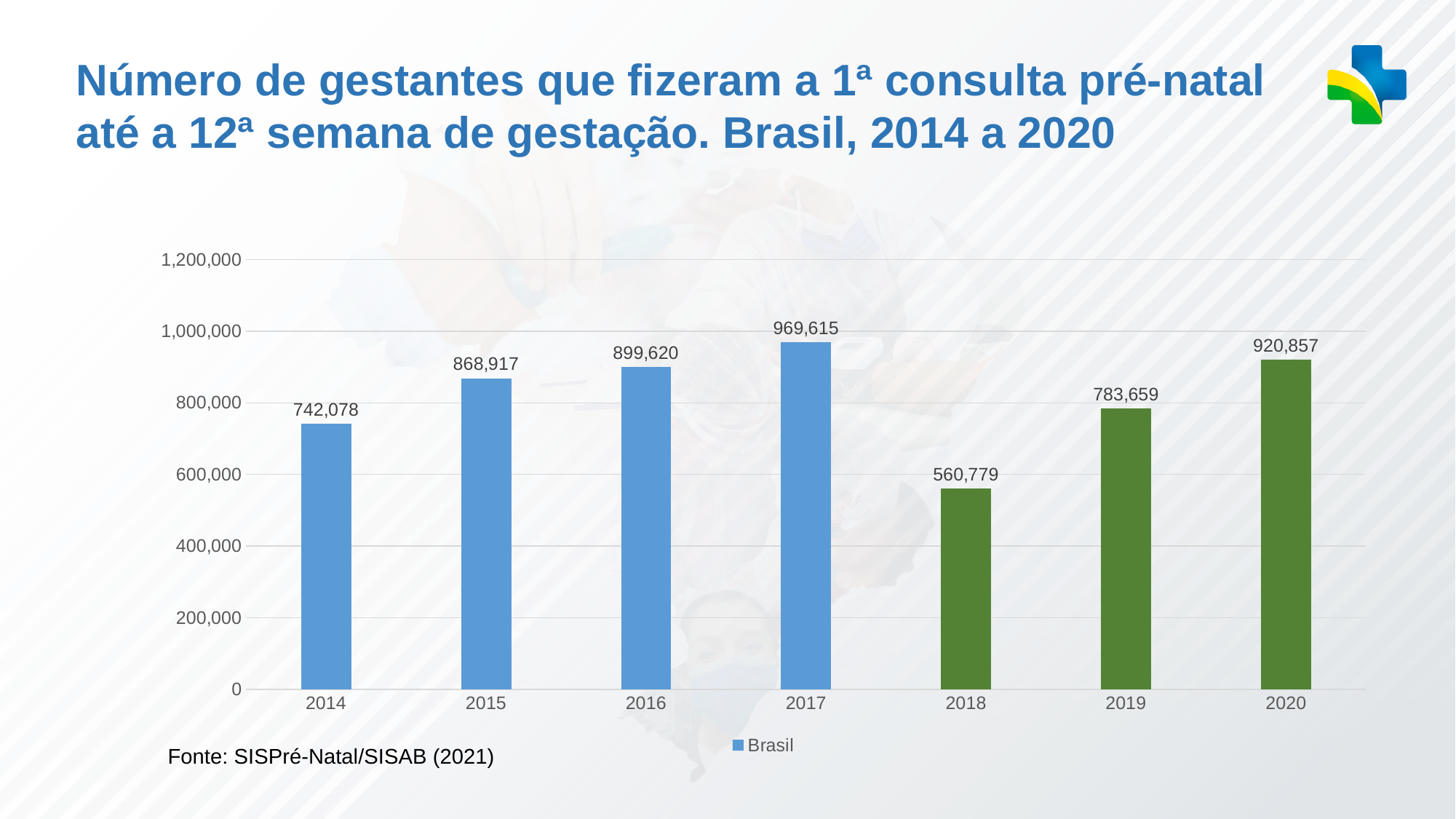
Is the value for 2015 greater or less than 800,000? greater What is the value for 2014? 742,078 What is the difference between the values for 2020 and 2019? 137,198 Which is larger, the value for 2016 or the value for 2020? 2020 How many years are shown on the x axis? 7 What is the name of the series in the legend? Brasil What kind of chart is shown? bar chart Which year has the highest value? 2017 What is the value for 2018? 560,779 Which year has the lowest value? 2018 How many series does the legend list? 1 What is the value for 2017? 969,615